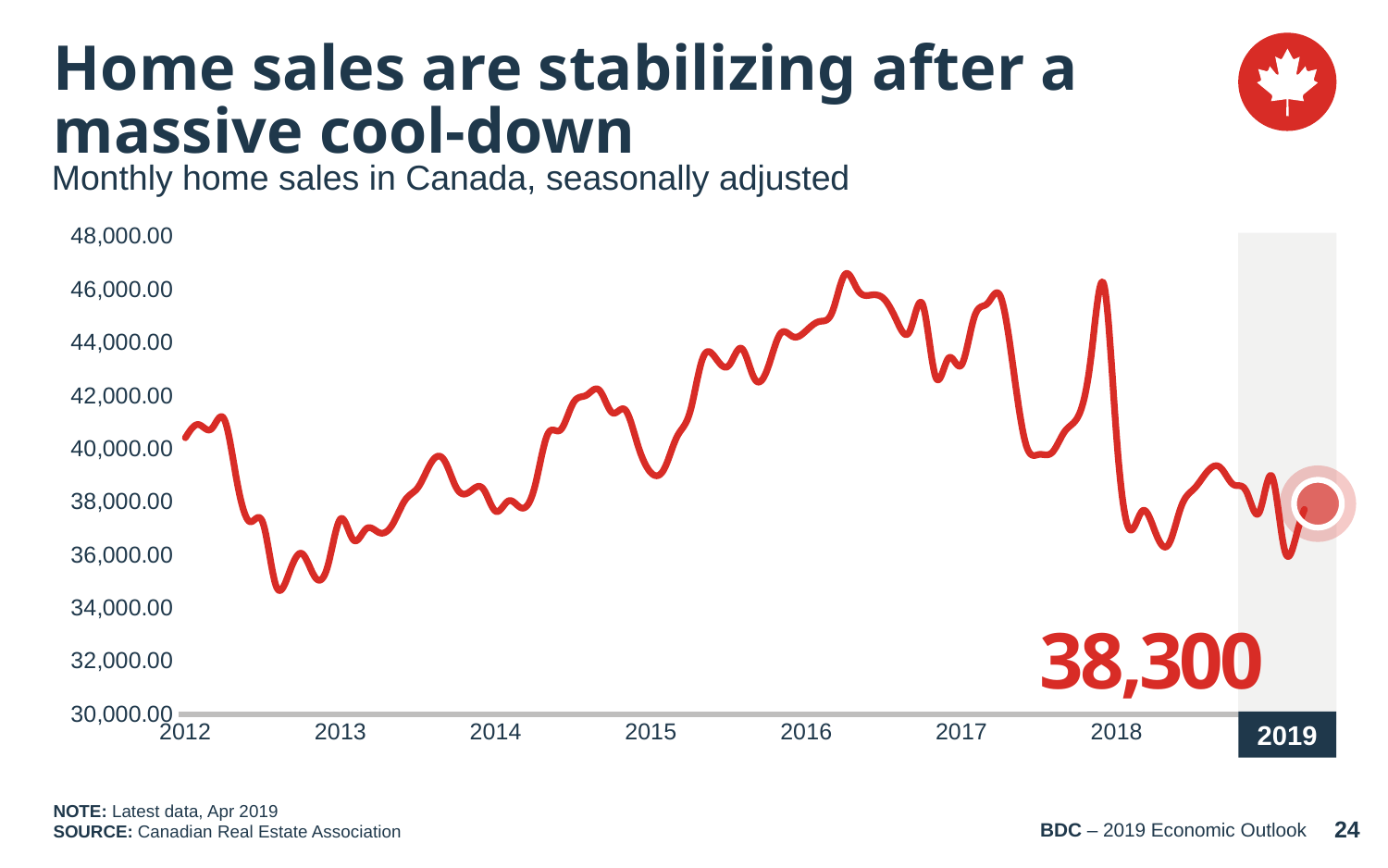
What is the latest value of monthly home sales highlighted on the chart? 38,300 In which year does the line reach its lowest point? 2012 What kind of chart is shown on the slide? line chart Is the value at the start of 2014 greater or less than 40,000.00? less How many data series are plotted on the chart? 1 What is the source of the data shown on the chart? Canadian Real Estate Association Does the line rise or fall between the start of 2017 and the start of 2018? fall Is the lowest point of the line in 2012 greater or less than 36,000.00? less Is the value at the start of 2012 greater or less than 38,000.00? greater How many year labels are shown along the x axis? 8 What is the subtitle describing the data plotted on the chart? Monthly home sales in Canada, seasonally adjusted